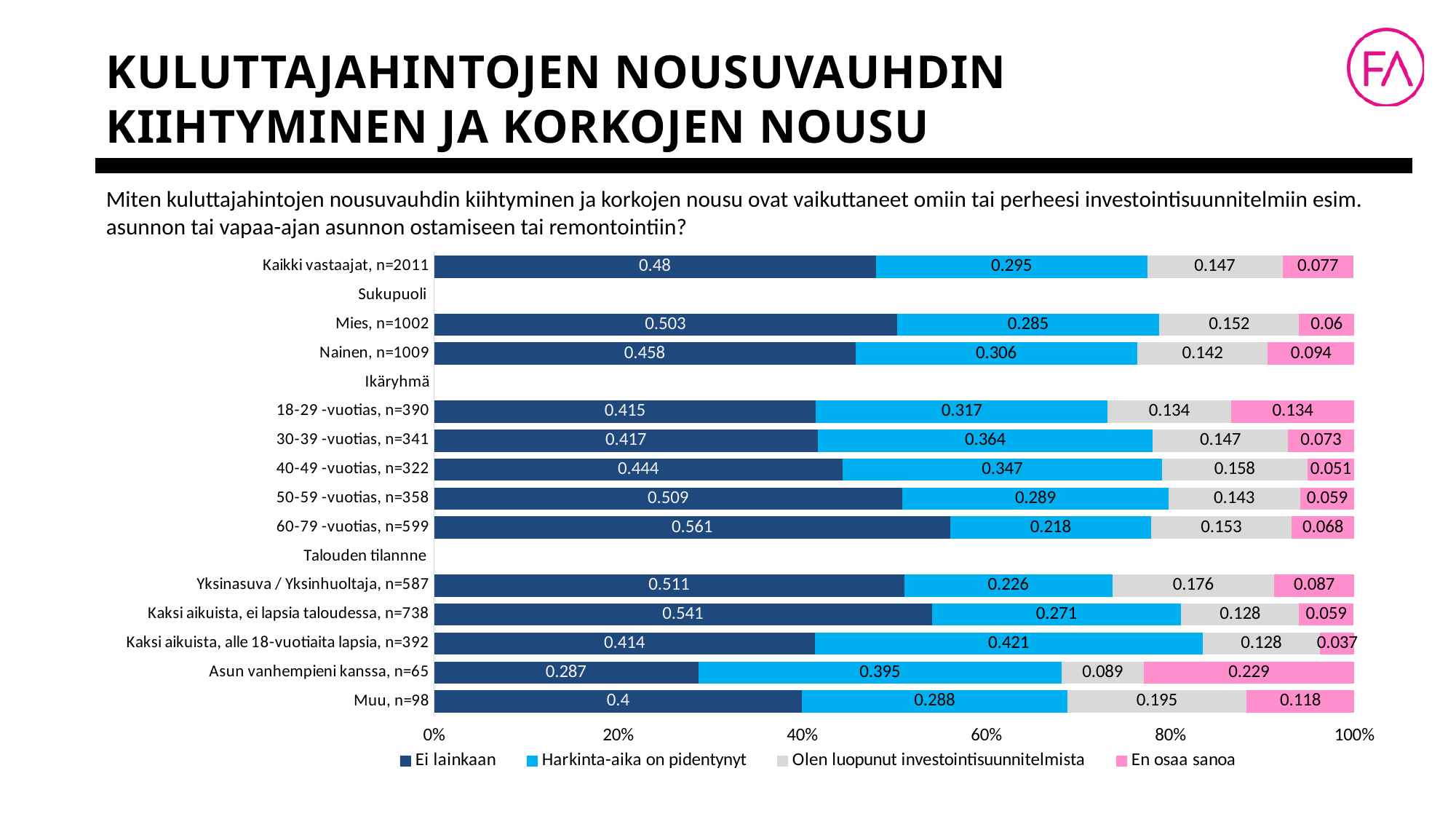
What is the value of "Harkinta-aika on pidentynyt" for "Kaksi aikuista, alle 18-vuotiaita lapsia, n=392"? 0.421 Which category has the highest value for "Ei lainkaan"? 60-79 -vuotias, n=599 What is the value of "En osaa sanoa" for "Asun vanhempieni kanssa, n=65"? 0.229 What is the difference between the "Ei lainkaan" values for "Mies, n=1002" and "Nainen, n=1009"? 0.045 What is the total of the stacked bar for "Kaikki vastaajat, n=2011"? 0.999 What kind of chart is shown on the slide? Stacked bar chart Which legend entry is shown in pink? En osaa sanoa What is the value of "Ei lainkaan" for "Kaikki vastaajat, n=2011"? 0.48 Is the "Ei lainkaan" value for "60-79 -vuotias, n=599" greater or less than 40%? greater Which has a larger "Olen luopunut investointisuunnitelmista" value: "Yksinasuva / Yksinhuoltaja, n=587" or "Muu, n=98"? Muu, n=98 Which category has the lowest value for "Ei lainkaan"? Asun vanhempieni kanssa, n=65 How many series does the legend list? 4